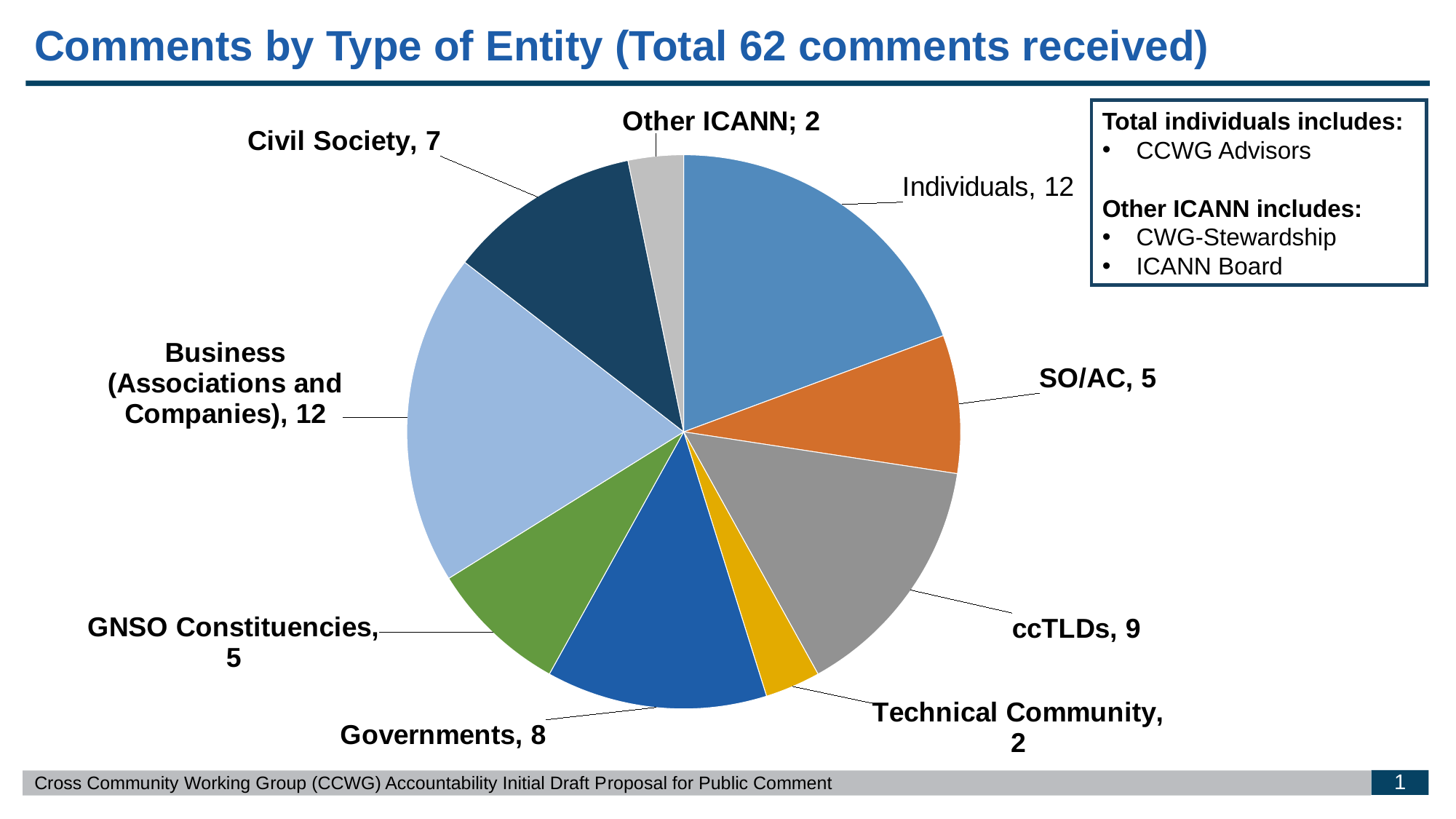
How many comments are attributed to Other ICANN? 2 How many categories (slices) does the pie chart have? 9 What is the difference between Civil Society and Technical Community comments? 5 What type of chart is shown on the slide? Pie chart What is the title of the chart? Comments by Type of Entity (Total 62 comments received) What is the value for Civil Society? 7 What is the value for Business (Associations and Companies)? 12 How many comments were received from Individuals? 12 How many comments came from Governments? 8 What is the value for ccTLDs? 9 What is the difference between the number of comments from Individuals and from SO/AC? 7 Which has more comments, ccTLDs or Governments? ccTLDs